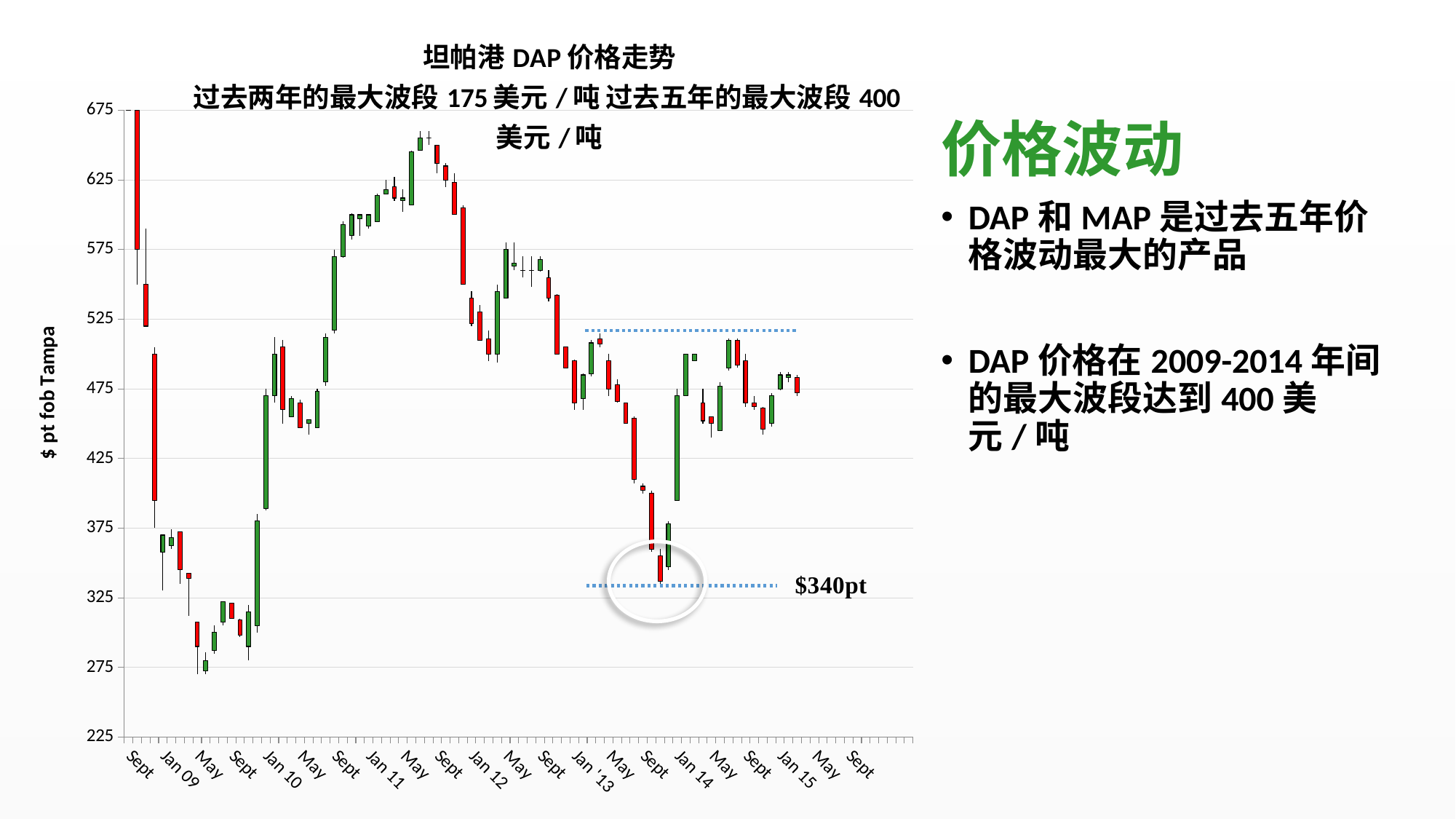
What price level is marked by the annotation next to the lower dotted line on the chart? $340pt Does the DAP price rise or fall between Jan 10 and May 11 on the chart? rise According to the chart title, what was the largest price swing over the past two years? 175 美元／吨 According to the chart title, what was the largest price swing over the past five years? 400 美元／吨 Is the DAP price around May 2009 greater or less than 325? less What kind of chart is shown on the slide? Candlestick (stock) chart What is the title of the chart? 坦帕港 DAP 价格走势 过去两年的最大波段 175 美元／吨 过去五年的最大波段 400 美元／吨 What is the highest value shown on the vertical axis of the chart? 675 What is the label on the vertical axis of the chart? $ pt fob Tampa Does the DAP price rise or fall between Sept 11 and Sept 13 on the chart? fall